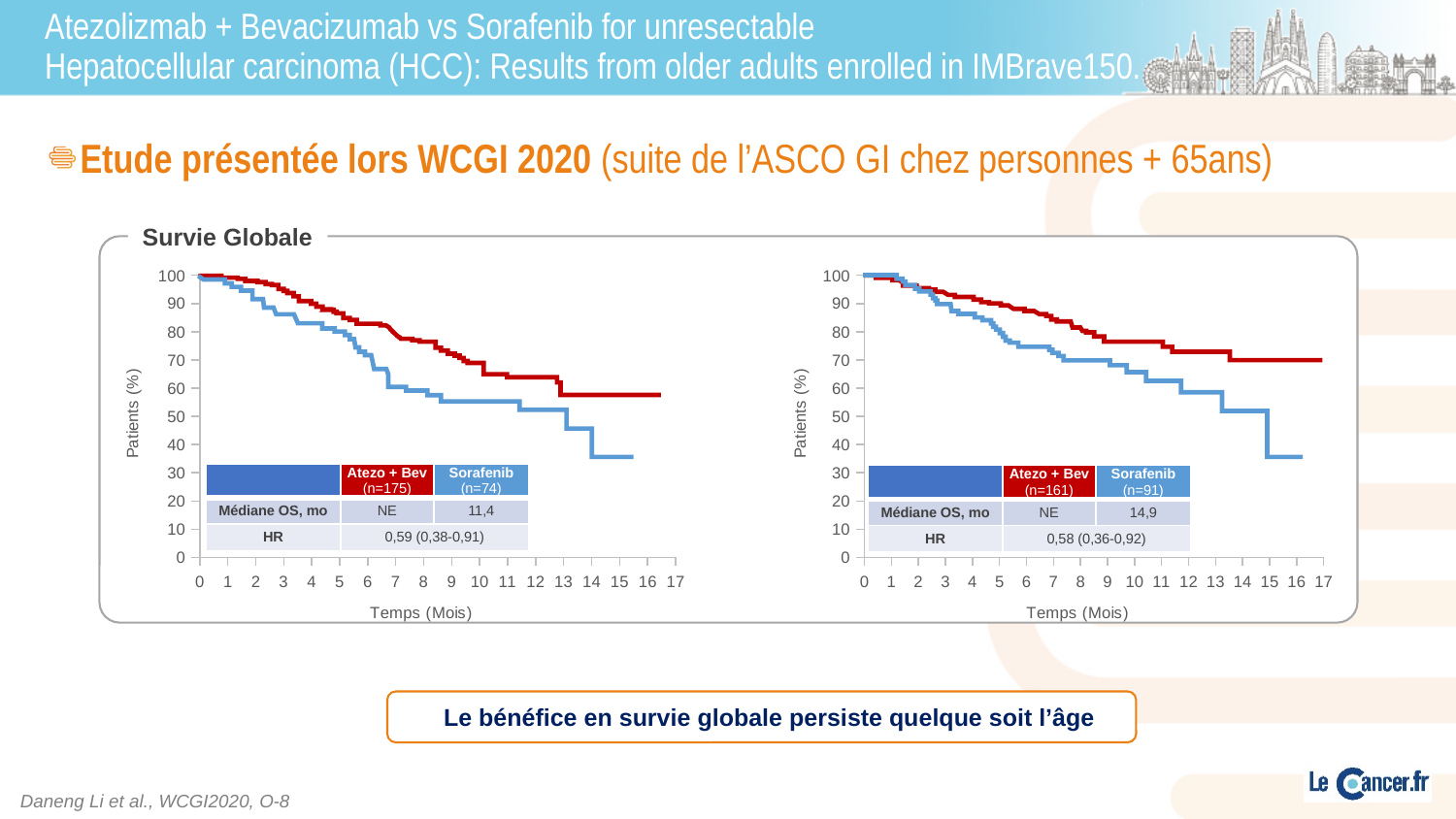
In the left chart, what is the median OS (mo) for Atezo + Bev? NE Do the curves in the right chart rise or fall along the x axis? fall In the left chart, what is the HR shown in the embedded table? 0,59 (0,38-0,91) What kind of chart is the left chart under 'Survie Globale'? line chart In the right chart, how many patients are in the Atezo + Bev group? 161 In the right chart, what is the HR shown in the embedded table? 0,58 (0,36-0,92) In the right chart, what is the median OS (mo) for Sorafenib according to the embedded table? 14,9 In the left chart, what is the median OS (mo) for Sorafenib according to the embedded table? 11,4 In the right chart, is the Atezo + Bev curve at 15 months greater or less than 60%? greater What is the x-axis label of the left chart? Temps (Mois) In the left chart, is the Sorafenib curve at 15 months greater or less than 40%? less In the left chart, which curve is higher at 10 months, Atezo + Bev or Sorafenib? Atezo + Bev